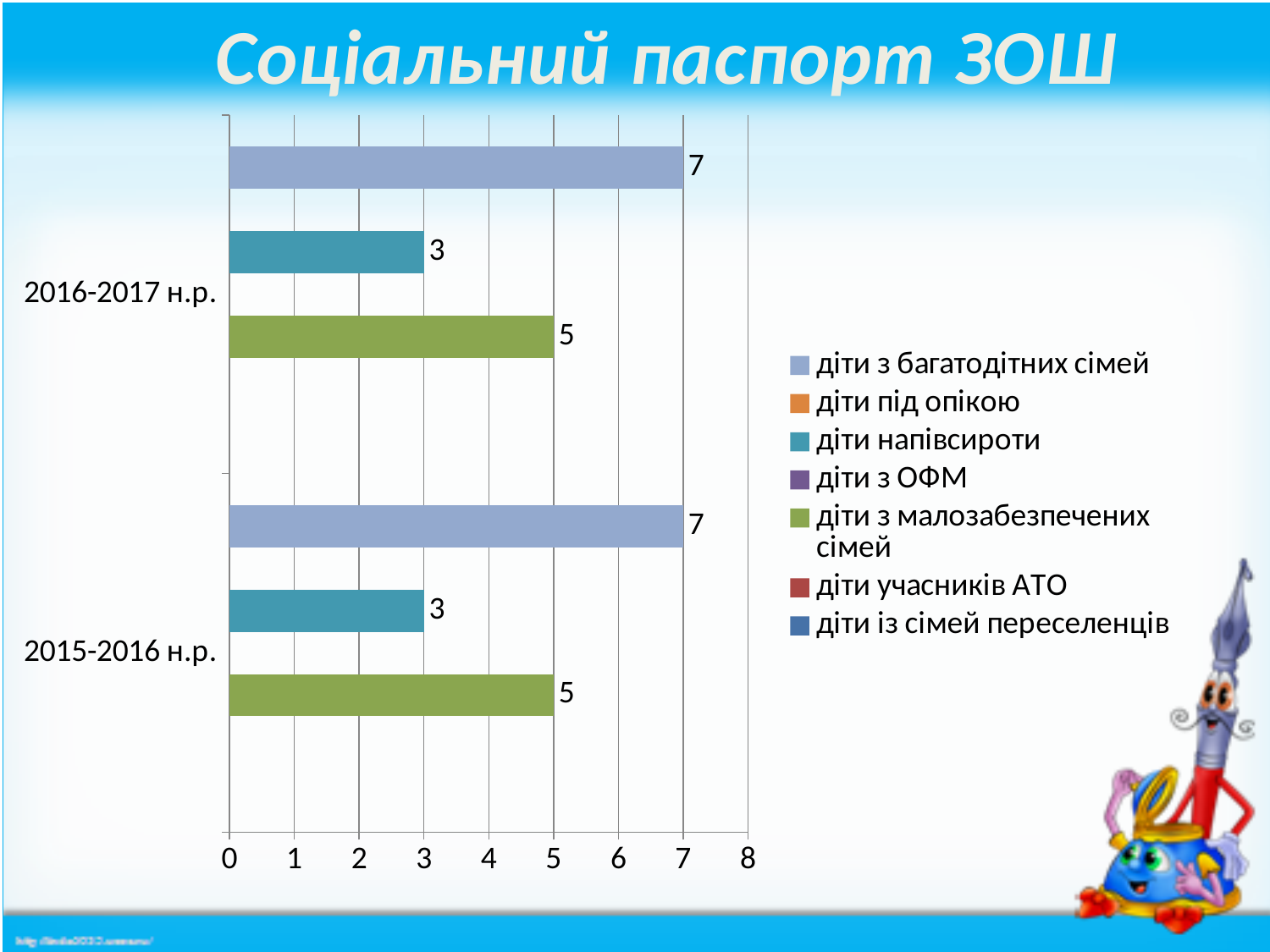
What is the title of the slide? Соціальний паспорт ЗОШ What is the value for діти з багатодітних сімей in 2016-2017 н.р.? 7 What is the value for діти напівсироти in 2015-2016 н.р.? 3 How many series does the legend list? 7 What is the difference between діти з багатодітних сімей and діти напівсироти in 2016-2017 н.р.? 4 What is the value for діти з малозабезпечених сімей in 2015-2016 н.р.? 5 What is the value for діти з малозабезпечених сімей in 2016-2017 н.р.? 5 Which is larger in 2015-2016 н.р.: діти з малозабезпечених сімей or діти напівсироти? діти з малозабезпечених сімей What kind of chart is shown on the slide? bar chart Which series has the highest value in 2015-2016 н.р.? діти з багатодітних сімей Which of the plotted series has the lowest value in 2016-2017 н.р.? діти напівсироти How many categories (school years) are shown on the vertical axis? 2